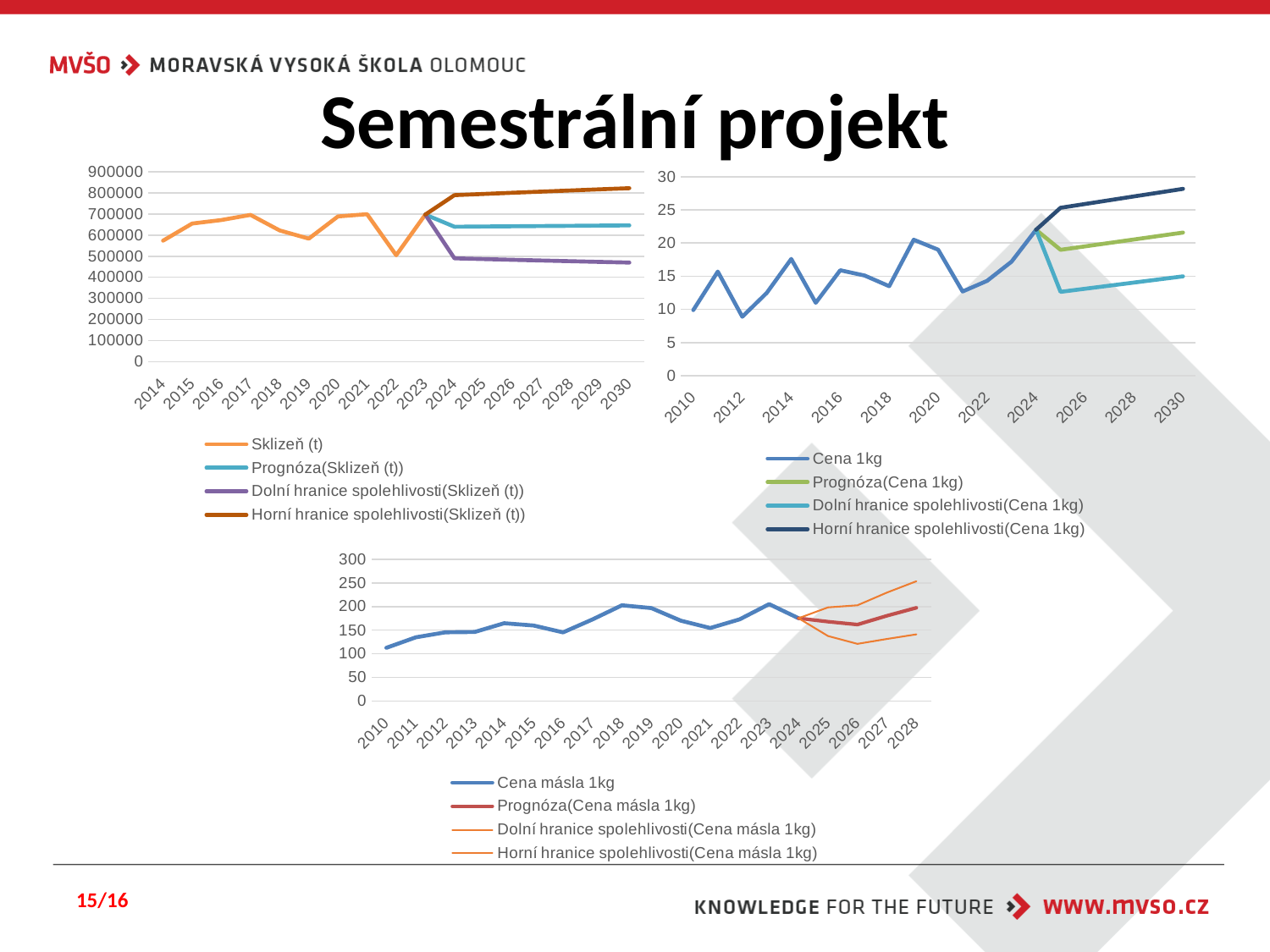
In the top-left chart, which year has the lowest value of Sklizeň (t)? 2022 In the top-right chart, is the value of Dolní hranice spolehlivosti(Cena 1kg) for 2026 greater or less than 15? less In the top-left chart, does the Dolní hranice spolehlivosti(Sklizeň (t)) line rise or fall from 2024 to 2030? fall How many series does the legend of the top-left chart (Sklizeň) list? 4 In the top-right chart, is the value of Horní hranice spolehlivosti(Cena 1kg) for 2030 greater or less than 25? greater In the bottom chart, which year has the lowest value of Cena másla 1kg? 2010 What kind of chart is the top-left chart (Sklizeň)? line chart How many years are shown on the x axis of the top-left chart (Sklizeň)? 17 How many series does the legend of the bottom chart (Cena másla 1kg) list? 4 In the top-left chart, is the value of Sklizeň (t) higher in 2015 or in 2019? 2015 In the top-left chart, is the value of Sklizeň (t) for 2022 greater or less than 600000? less In the bottom chart, is the value of Cena másla 1kg higher in 2018 or in 2021? 2018